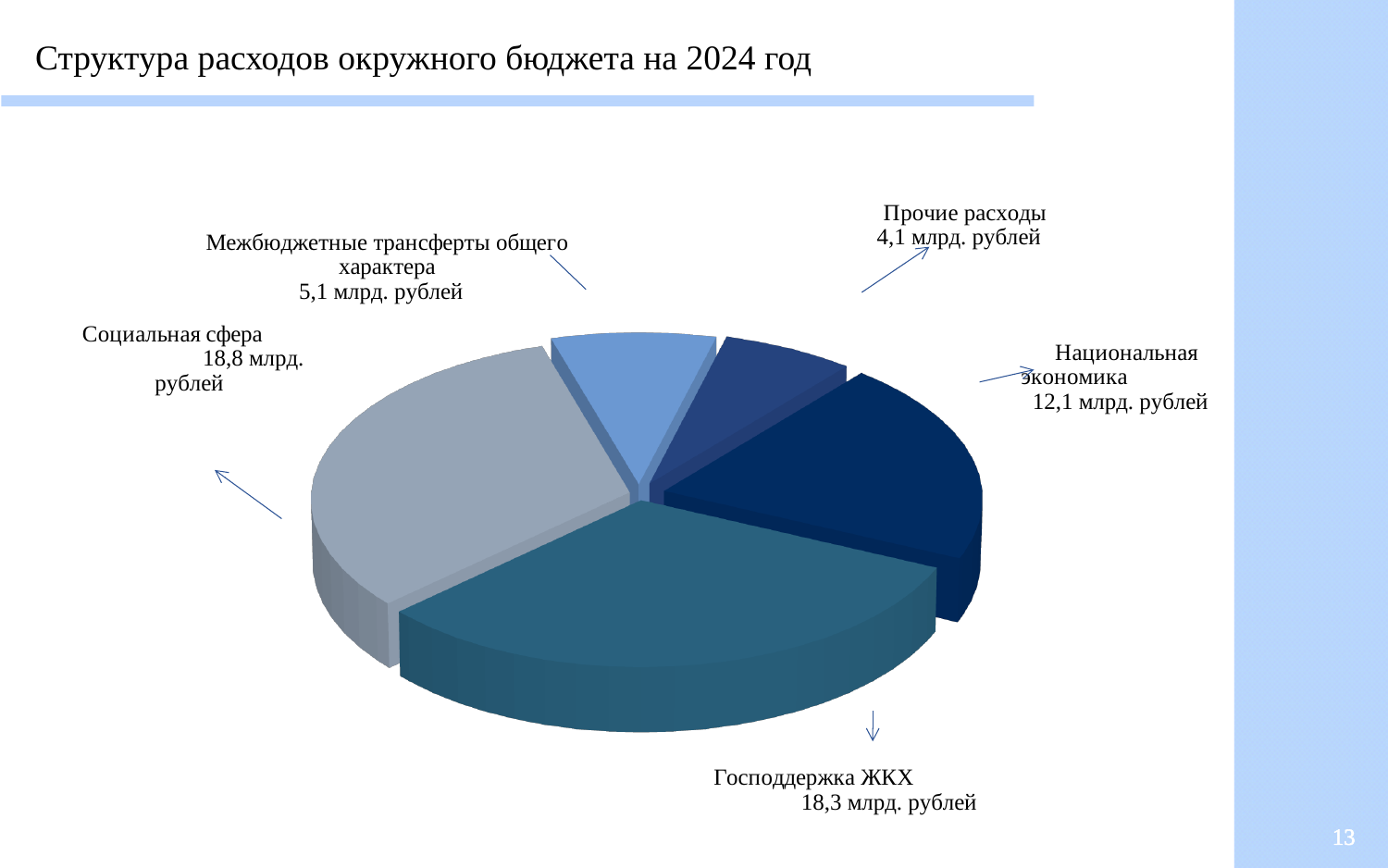
What is the value for Национальная экономика? 12,1 млрд. рублей What is the value for Социальная сфера? 18,8 млрд. рублей What is the value for Господдержка ЖКХ? 18,3 млрд. рублей What is the value for Прочие расходы? 4,1 млрд. рублей What is the title of the chart on the slide? Структура расходов окружного бюджета на 2024 год What is the difference between Национальная экономика and Прочие расходы? 8,0 млрд. рублей Which category has the largest value? Социальная сфера Which is larger, Господдержка ЖКХ or Национальная экономика? Господдержка ЖКХ What is the value for Межбюджетные трансферты общего характера? 5,1 млрд. рублей How many slices does the pie chart have? 5 What kind of chart is shown on the slide? Pie chart Which category has the smallest value? Прочие расходы